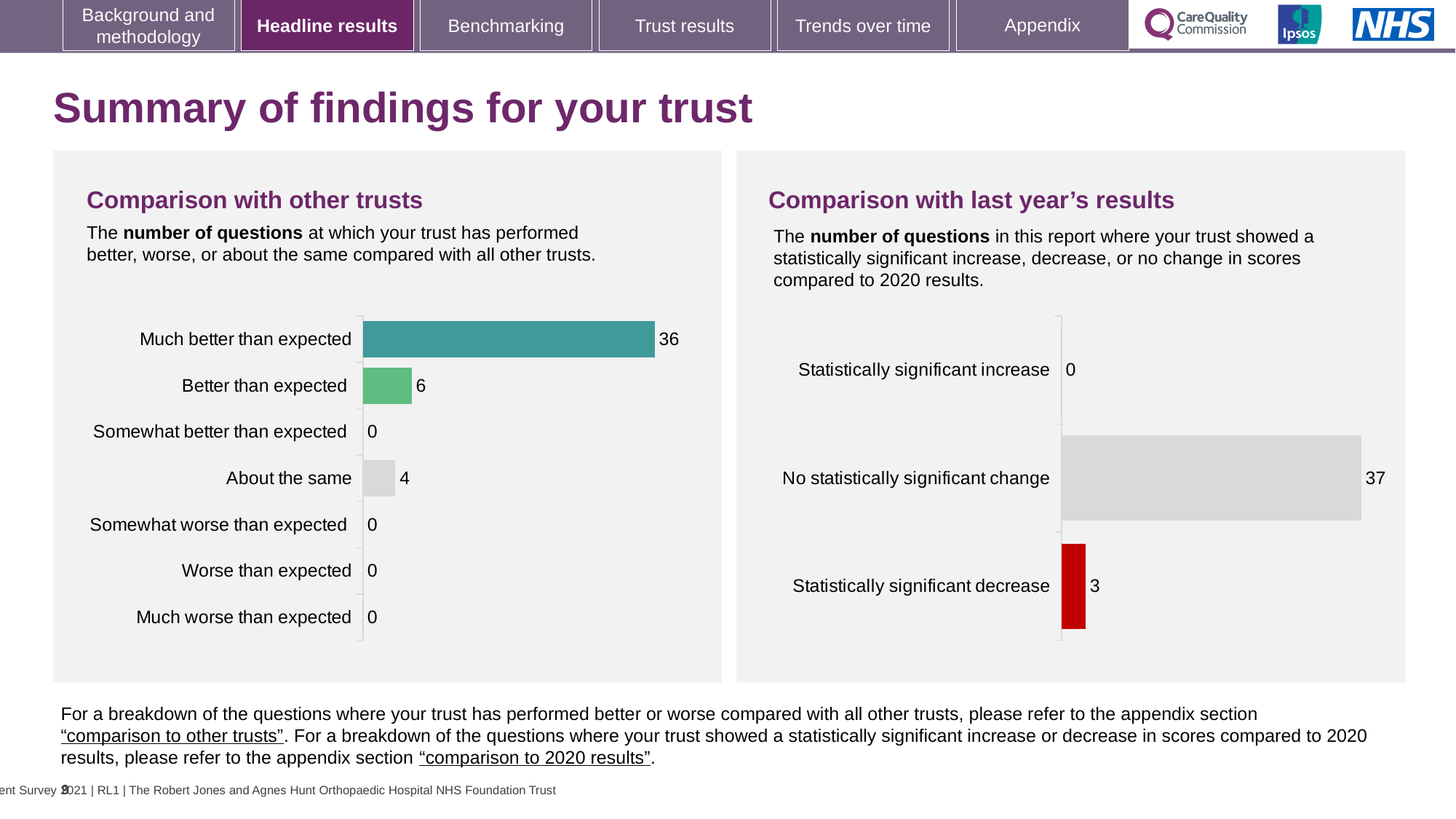
In the 'Comparison with other trusts' chart, how many questions were 'Much better than expected'? 36 In the 'Comparison with other trusts' chart, which is larger: 'Better than expected' or 'About the same'? Better than expected In the 'Comparison with last year's results' chart, what is the value for 'Statistically significant decrease'? 3 What type of chart is used in the 'Comparison with last year's results' panel? Bar chart In the 'Comparison with last year's results' chart, which category has the lowest value? Statistically significant increase In the 'Comparison with last year's results' chart, what is the value for 'No statistically significant change'? 37 In the 'Comparison with other trusts' chart, which category has the highest value? Much better than expected In the 'Comparison with other trusts' chart, what is the difference between 'Much better than expected' and 'Better than expected'? 30 In the 'Comparison with other trusts' chart, what is the value for 'About the same'? 4 In the 'Comparison with other trusts' chart, what is the value for 'Better than expected'? 6 In the 'Comparison with other trusts' chart, how many categories are shown? 7 In the 'Comparison with last year's results' chart, what is the total of the three categories? 40